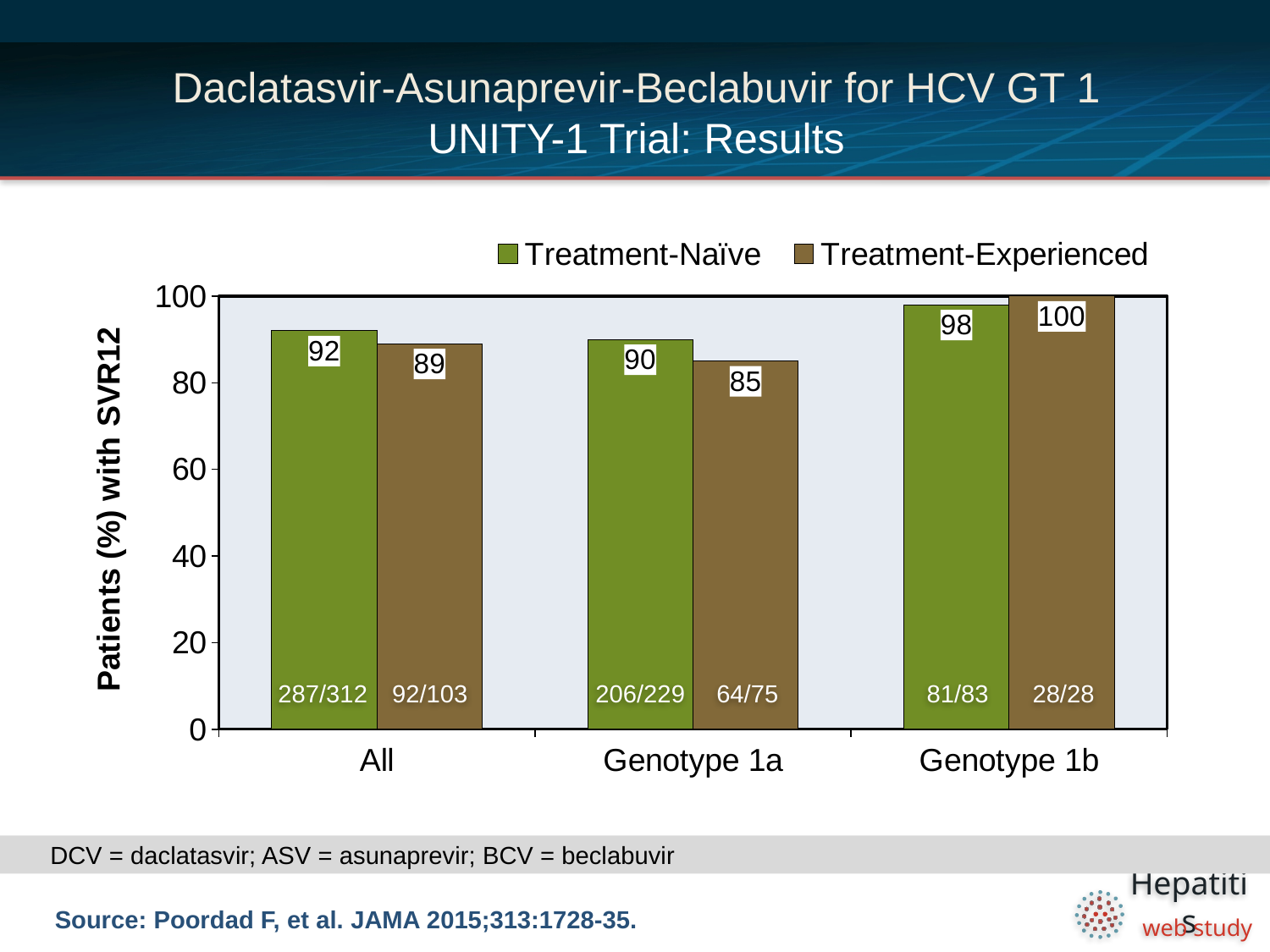
What is the SVR12 rate for Treatment-Experienced patients with Genotype 1b? 100 Which genotype group has the lowest SVR12 rate among Treatment-Experienced patients? Genotype 1a How many patient groups are shown on the x axis? 3 What is the SVR12 rate for Treatment-Experienced patients with Genotype 1a? 85 What kind of chart is shown on the slide? Bar chart In the All group, which is larger: the Treatment-Naïve or the Treatment-Experienced SVR12 rate? Treatment-Naïve What is the SVR12 rate for Treatment-Naïve patients with Genotype 1a? 90 What is the SVR12 rate for Treatment-Naïve patients in the All group? 92 How many series does the legend list? 2 Which group has the highest SVR12 rate among Treatment-Naïve patients? Genotype 1b What is the label of the y axis? Patients (%) with SVR12 What is the difference between the Treatment-Naïve and Treatment-Experienced SVR12 rates in the Genotype 1a group? 5